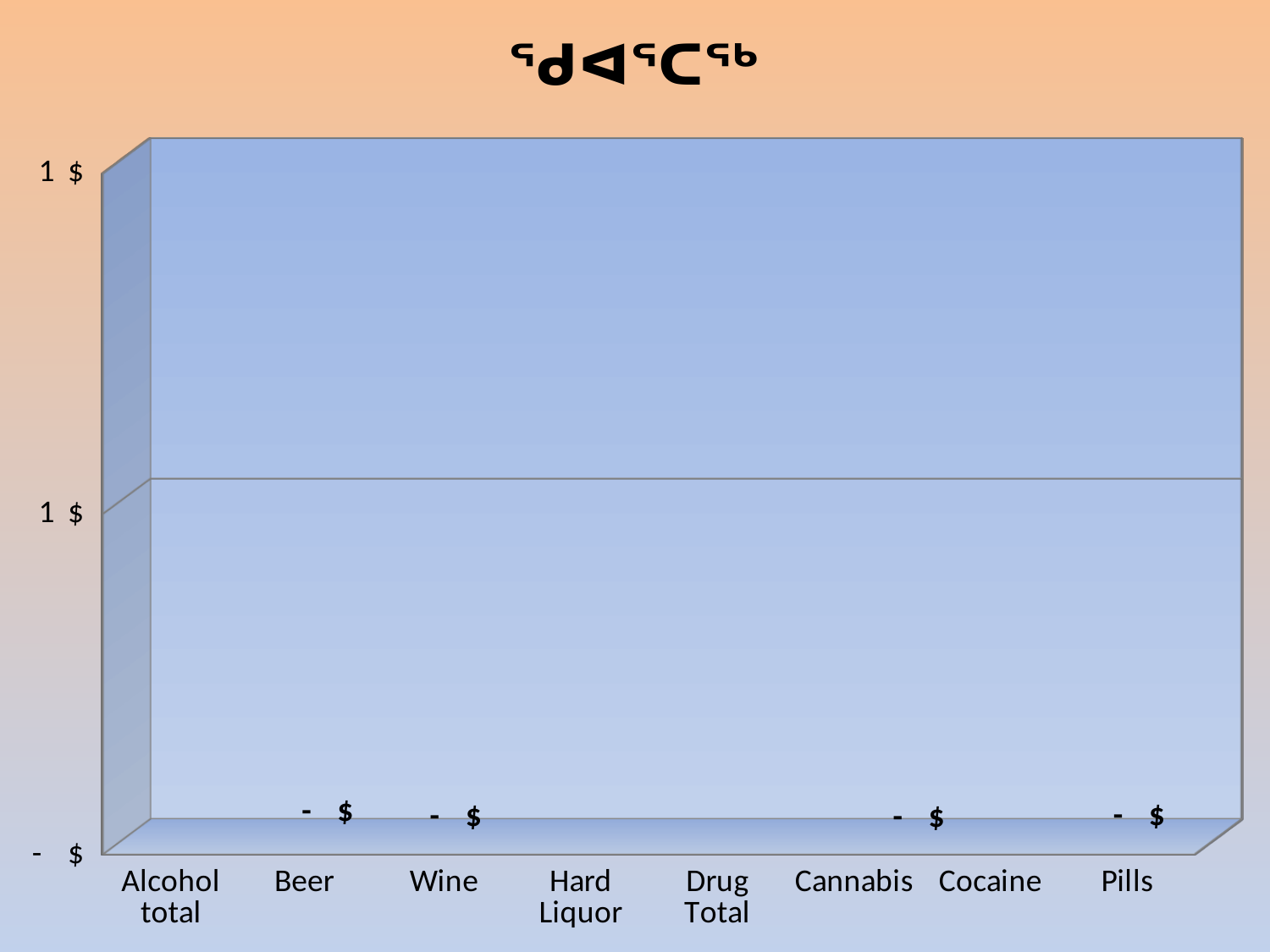
What is the first category listed on the x axis? Alcohol total What data label is printed for Wine? - $ What data label is printed for Cannabis? - $ What is the last category listed on the x axis? Pills What data label is printed for Beer? - $ What kind of chart is shown on the slide? bar chart What data label is printed for Pills? - $ How many categories are shown on the x axis of the chart? 8